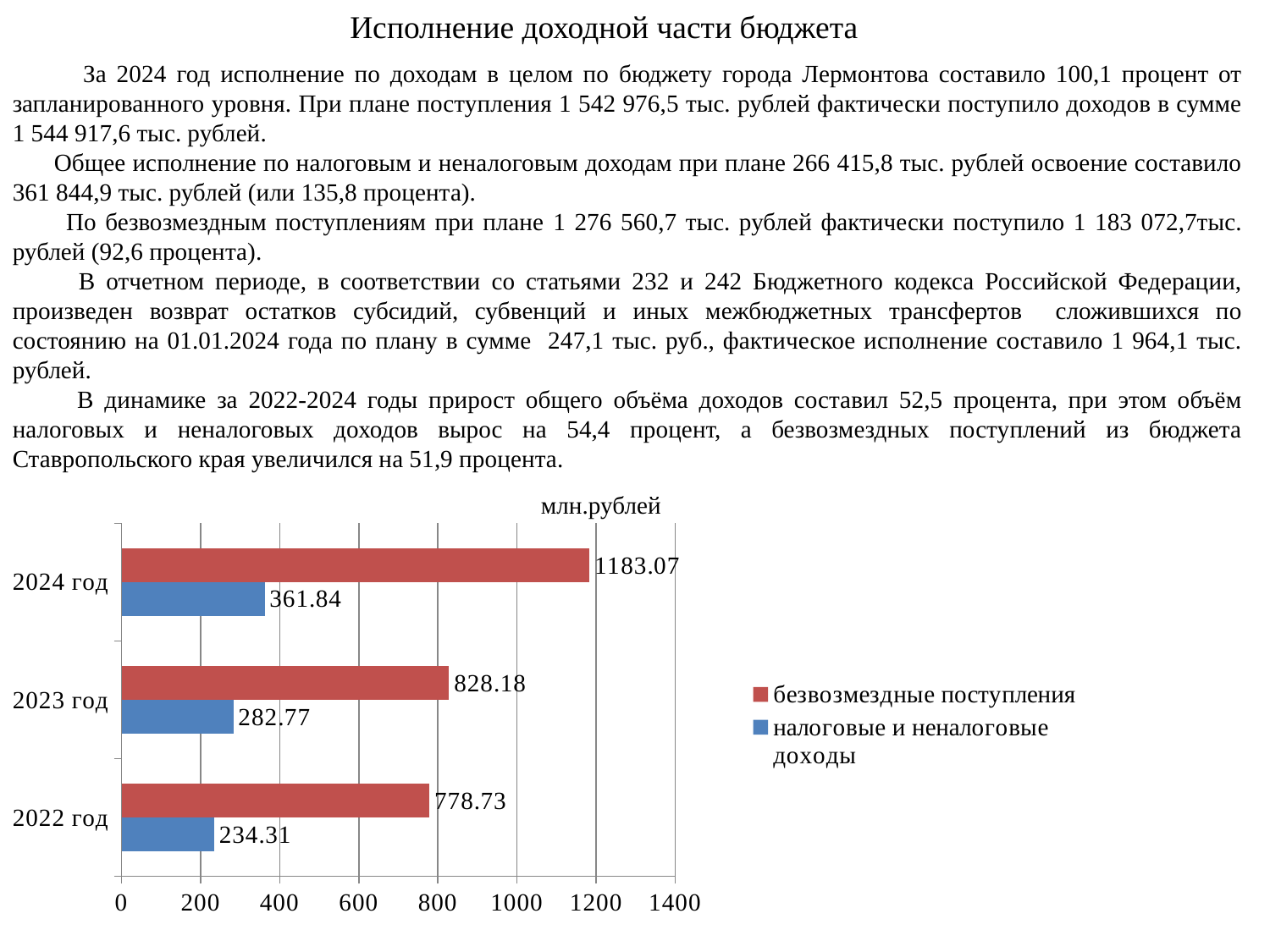
Is the value of безвозмездные поступления for 2024 год greater or less than 1000? greater Which year has the lowest value for налоговые и неналоговые доходы? 2022 год What is the value of налоговые и неналоговые доходы for 2023 год? 282.77 What is the value of налоговые и неналоговые доходы for 2022 год? 234.31 What is the difference in безвозмездные поступления between 2023 год and 2022 год? 49.45 What is the value of безвозмездные поступления for 2024 год? 1183.07 Which is larger: безвозмездные поступления in 2023 год or in 2022 год? 2023 год Which year has the highest value for безвозмездные поступления? 2024 год How many series does the legend list? 2 What is the difference between безвозмездные поступления and налоговые и неналоговые доходы in 2024 год? 821.23 What type of chart is shown on the slide? bar chart How many years are shown on the chart? 3